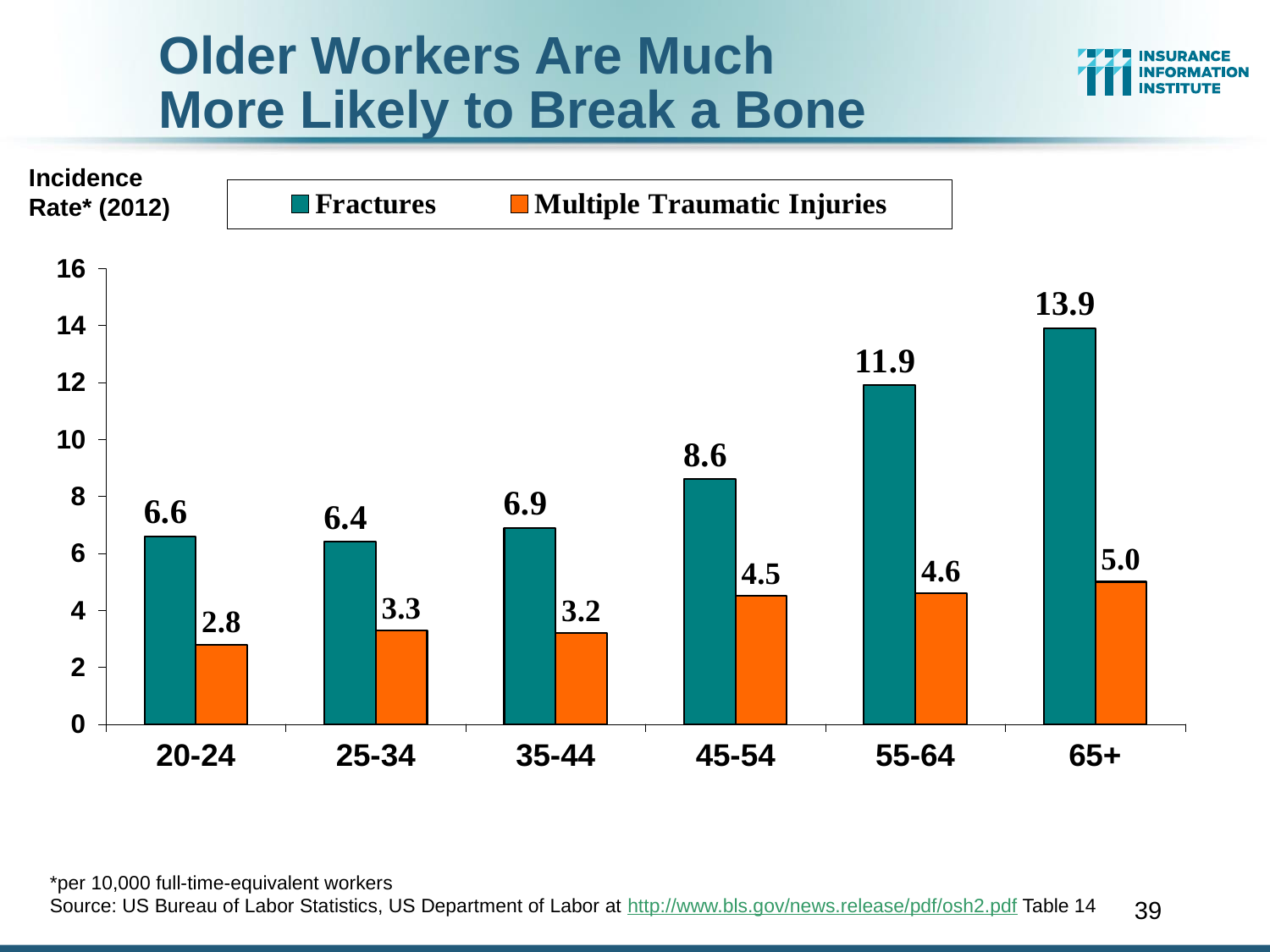
How many series does the legend list? 2 Which age group has the lowest Multiple Traumatic Injuries incidence rate? 20-24 Which is larger, the Fractures rate for 25-34 or the Fractures rate for 35-44? 35-44 Which age group has the highest Fractures incidence rate? 65+ Do the Fractures values generally rise or fall from the 35-44 age group to the 65+ age group? Rise What is the Fractures incidence rate for the 45-54 age group? 8.6 What is the Multiple Traumatic Injuries incidence rate for the 20-24 age group? 2.8 What is the difference between the Fractures rate and the Multiple Traumatic Injuries rate for the 45-54 age group? 4.1 What is the Fractures incidence rate for the 65+ age group? 13.9 What is the difference between the Fractures rate for 65+ and the Fractures rate for 55-64? 2.0 What kind of chart is shown on the slide? Bar chart How many age groups are shown on the x axis? 6